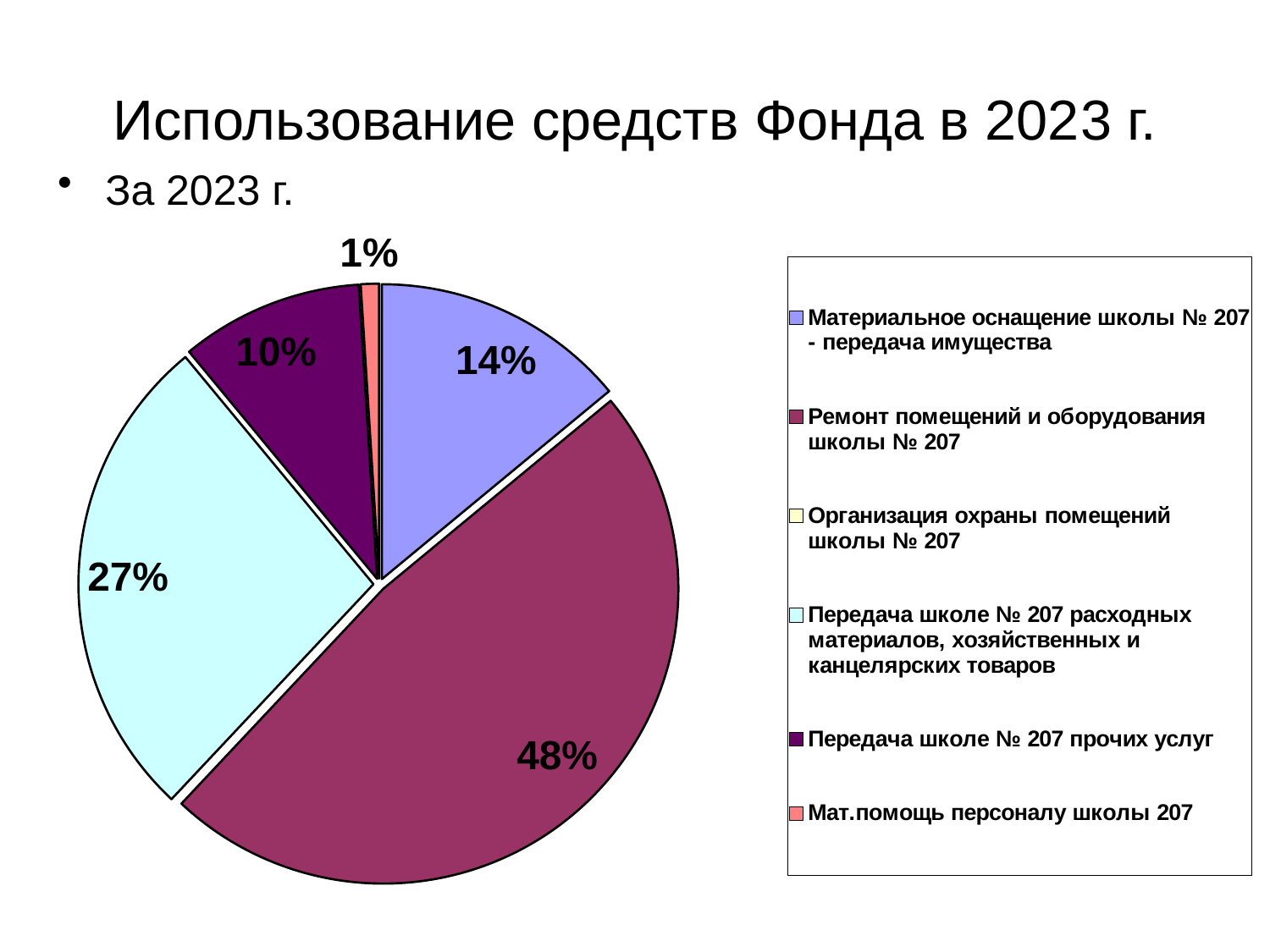
How many entries does the legend list? 6 What is the title of the slide containing the chart? Использование средств Фонда в 2023 г. By how many percentage points does the "Ремонт помещений и оборудования школы № 207" slice exceed the "Передача школе № 207 расходных материалов, хозяйственных и канцелярских товаров" slice? 21 percentage points What is the combined share of the "Ремонт помещений и оборудования школы № 207" and "Передача школе № 207 расходных материалов, хозяйственных и канцелярских товаров" slices? 75% What share of the pie is labelled for "Ремонт помещений и оборудования школы № 207"? 48% Which category has the largest slice of the pie? Ремонт помещений и оборудования школы № 207 What share of the pie is labelled for "Мат.помощь персоналу школы 207"? 1% What share of the pie is labelled for "Передача школе № 207 прочих услуг"? 10% What share of the pie is labelled for "Передача школе № 207 расходных материалов, хозяйственных и канцелярских товаров"? 27% What share of the pie is labelled for "Материальное оснащение школы № 207 - передача имущества"? 14% What kind of chart is shown on the slide? pie chart Which slice is larger: "Материальное оснащение школы № 207 - передача имущества" or "Передача школе № 207 прочих услуг"? Материальное оснащение школы № 207 - передача имущества